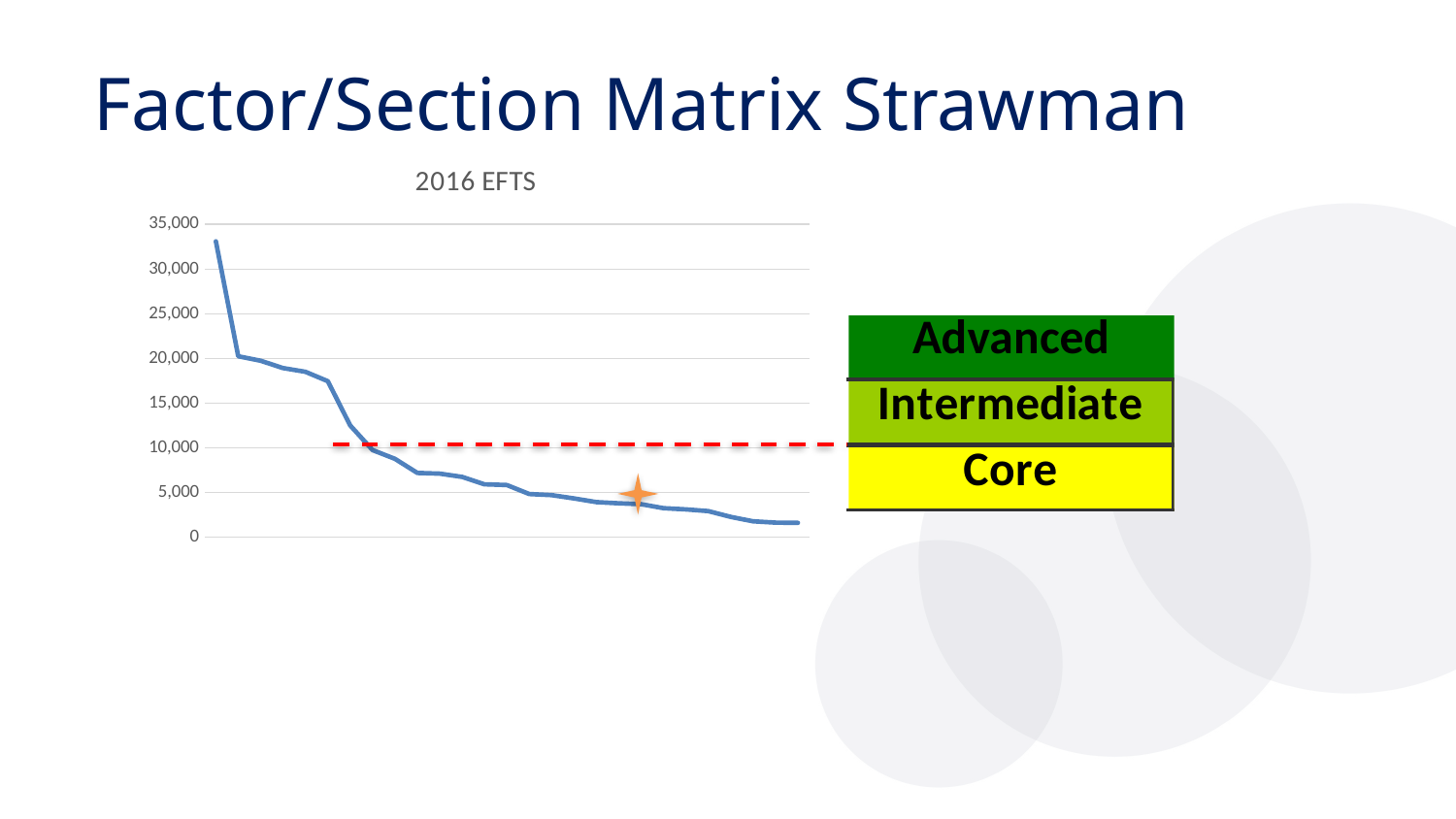
What is the highest value shown on the y axis? 35,000 Is the value of the first (leftmost) point on the line greater or less than 30,000? greater Is the value of the last (rightmost) point on the line greater or less than 5,000? less Is the value at the point marked with the orange star greater or less than 10,000? less Which point on the line has the highest value, the leftmost or the rightmost? leftmost What kind of chart is shown on the slide? line chart What is the title of the chart? 2016 EFTS Is the leftmost point or the rightmost point of the line larger? leftmost Do the values on the chart rise or fall from left to right along the x axis? fall